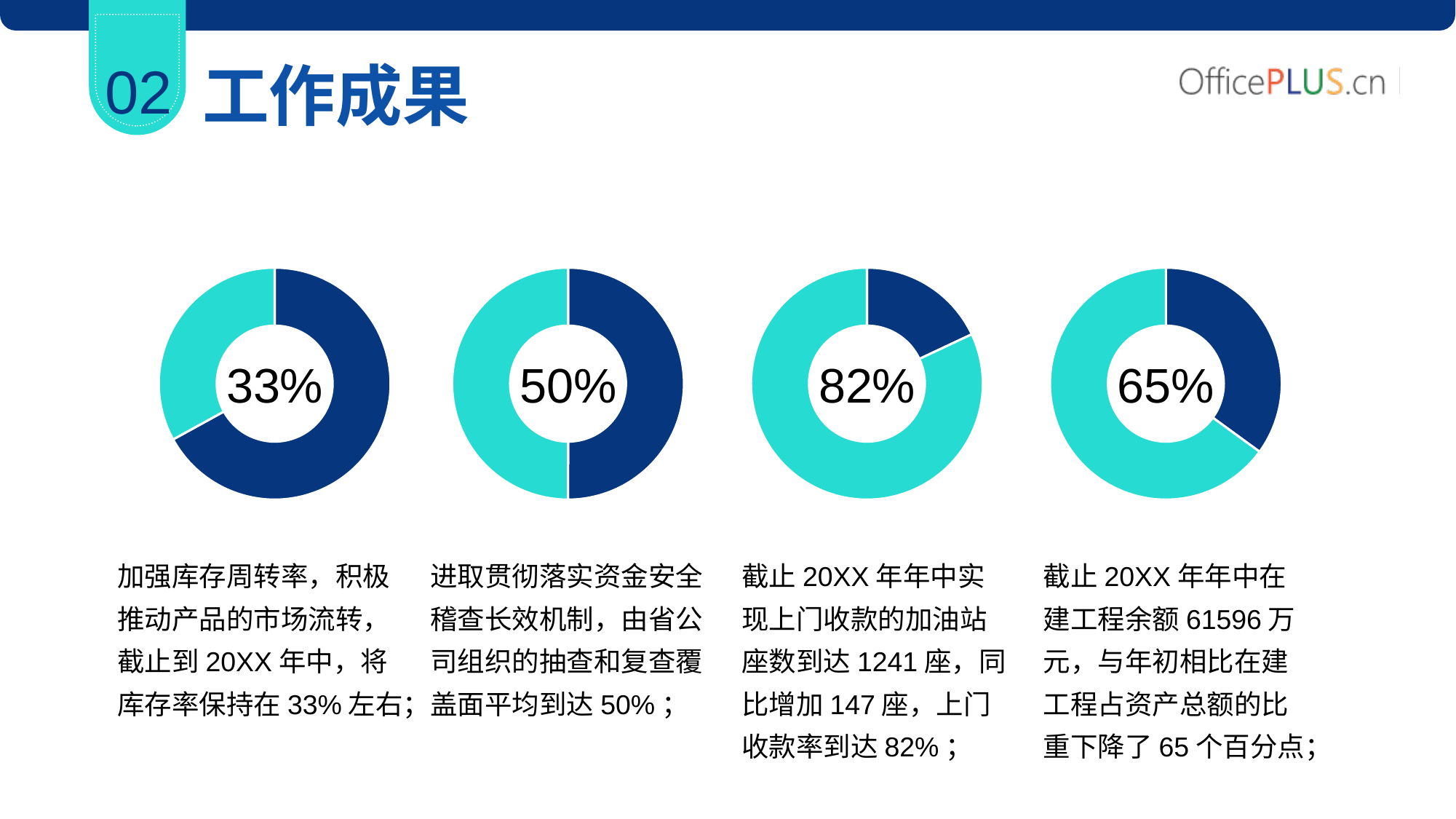
What percentage is shown in the centre of the second donut chart from the left? 50% Which donut chart shows the lowest percentage? The leftmost (33%) What two colours are used for the segments of the donut charts? Dark blue and cyan What percentage is shown in the centre of the rightmost donut chart? 65% Is the percentage in the rightmost donut chart larger or smaller than the percentage in the leftmost donut chart? Larger Which donut chart shows the highest percentage? The third from the left (82%) What percentage is shown in the centre of the third donut chart from the left? 82% How many donut charts are on the slide? 4 What kind of chart is used on this slide? Donut chart What is the difference between the percentage in the third donut chart (82%) and the percentage in the rightmost donut chart (65%)? 17 percentage points What is the difference between the percentage in the second donut chart (50%) and the percentage in the leftmost donut chart (33%)? 17 percentage points What percentage is shown in the centre of the leftmost donut chart? 33%